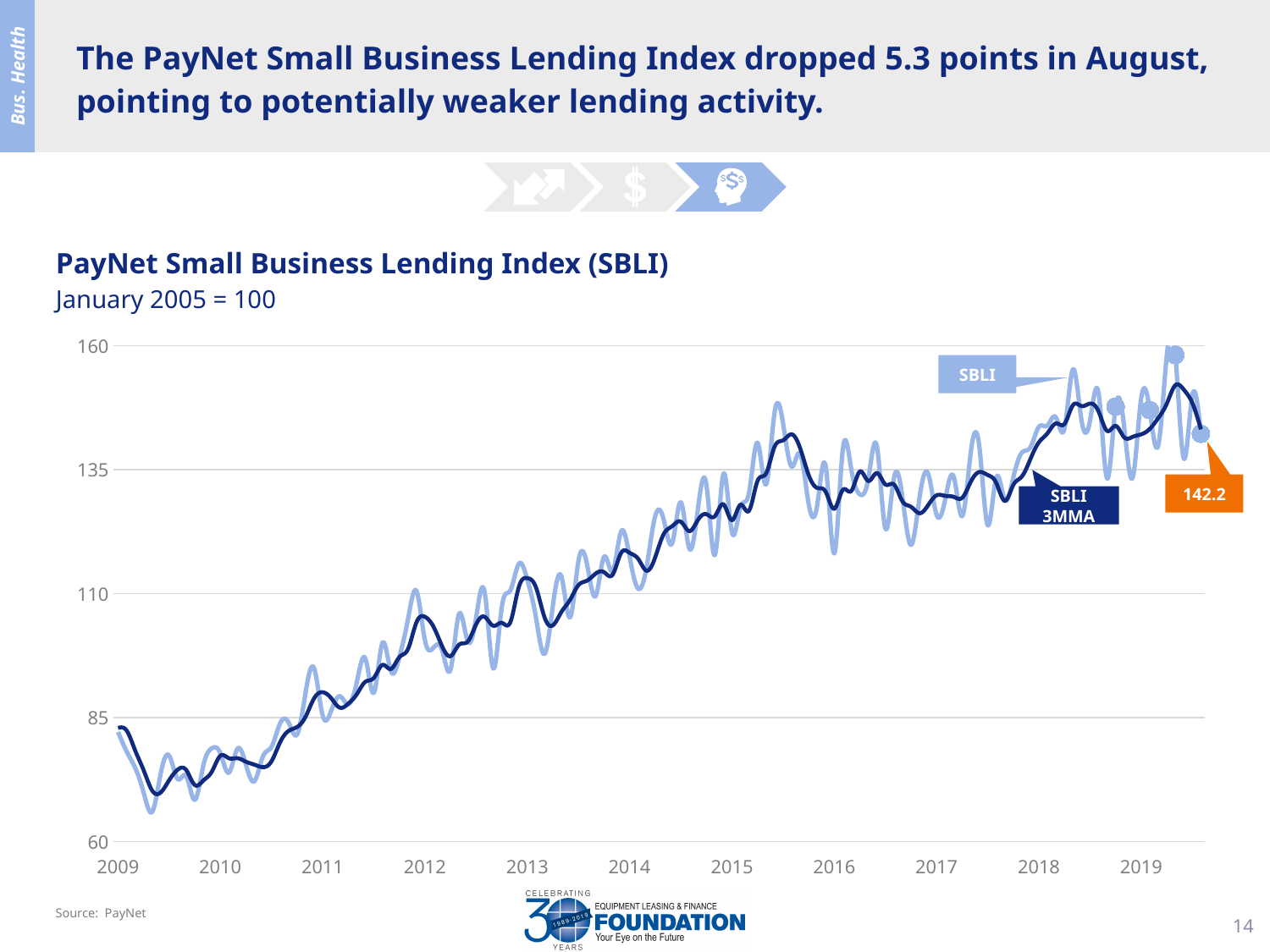
How many year labels are shown on the x axis? 11 What is the title of the chart? PayNet Small Business Lending Index (SBLI) Which is larger: the SBLI 3MMA value at the start of 2016 or at the start of 2010? start of 2016 Is the highest SBLI value in 2019 greater or less than 135? greater Overall, do the SBLI values rise or fall from 2009 to 2019? rise Is the SBLI 3MMA value at the start of 2017 greater or less than 135? less Is the SBLI 3MMA value at the start of 2014 greater or less than 110? greater What kind of chart is shown on the slide? line chart What is the latest SBLI value labeled on the chart? 142.2 What base period is the index set to 100, according to the chart subtitle? January 2005 How many series are plotted on the chart? 2